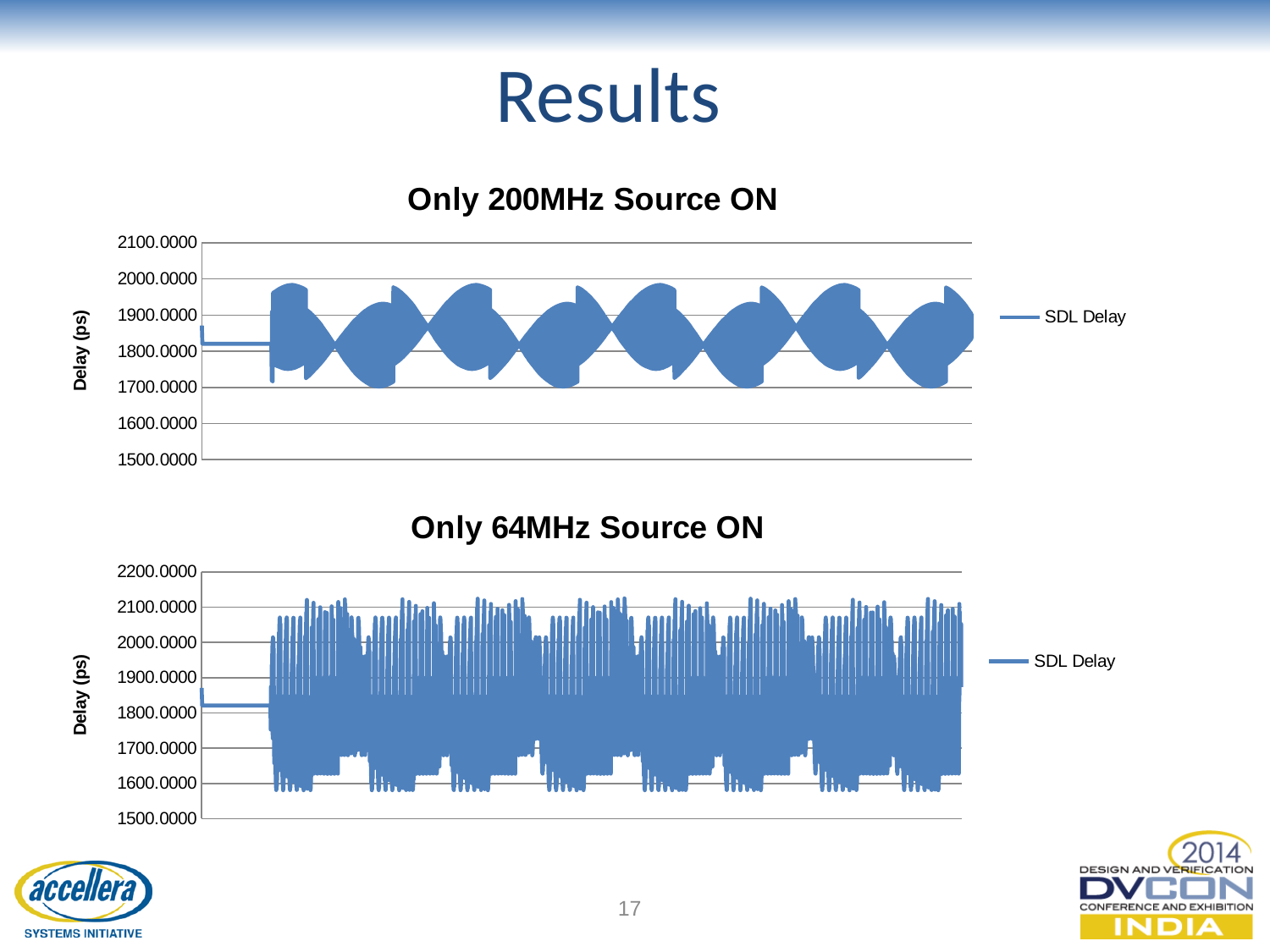
How many series does the legend of the "Only 200MHz Source ON" chart list? 1 How many series does the legend of the "Only 64MHz Source ON" chart list? 1 In the "Only 200MHz Source ON" chart, is the lowest SDL Delay value greater or less than 1800? less In the "Only 64MHz Source ON" chart, is the lowest SDL Delay value greater or less than 1600? less In the "Only 64MHz Source ON" chart, is the highest SDL Delay value greater or less than 2100? greater What kind of chart is the "Only 200MHz Source ON" chart? line chart Which chart reaches a higher peak SDL Delay, "Only 200MHz Source ON" or "Only 64MHz Source ON"? Only 64MHz Source ON What kind of chart is the "Only 64MHz Source ON" chart? line chart What is the name of the series shown in the legend of the "Only 64MHz Source ON" chart? SDL Delay What is the y-axis label of the "Only 200MHz Source ON" chart? Delay (ps)